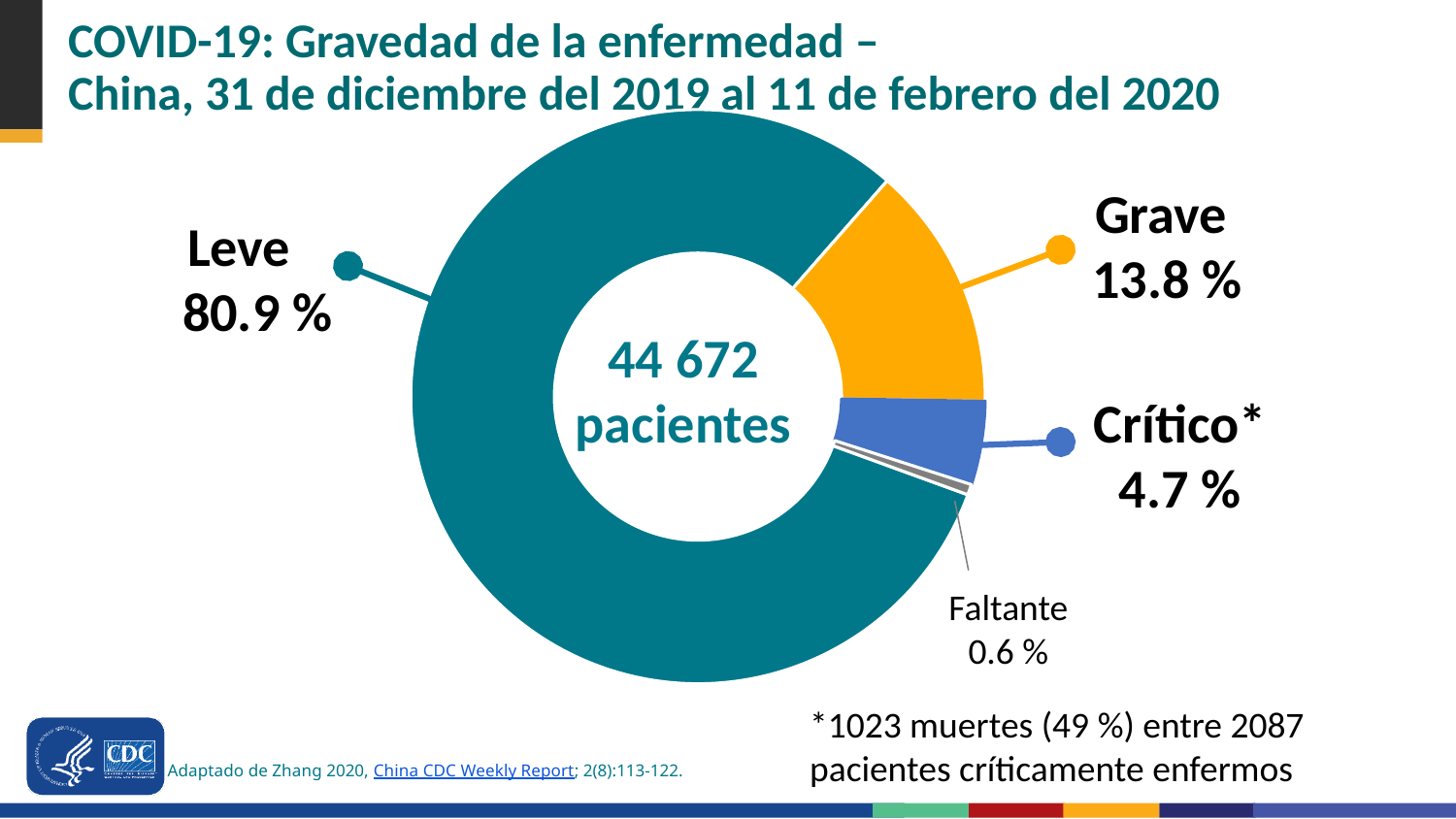
What kind of chart is shown on the slide? Pie chart (donut) What percentage of patients are in the Crítico category? 4.7 % What colour is the Grave slice of the chart? Orange Which category has a larger share, Grave or Crítico? Grave What percentage of patients are in the Faltante category? 0.6 % How many categories are shown in the chart? 4 What is the difference in percentage points between the Grave and Crítico categories? 9.1 Which category has the smallest share of patients? Faltante Which category has the largest share of patients? Leve What total number of patients is shown in the centre of the chart? 44 672 pacientes What percentage of patients are in the Grave category? 13.8 % What percentage of patients are in the Leve category? 80.9 %